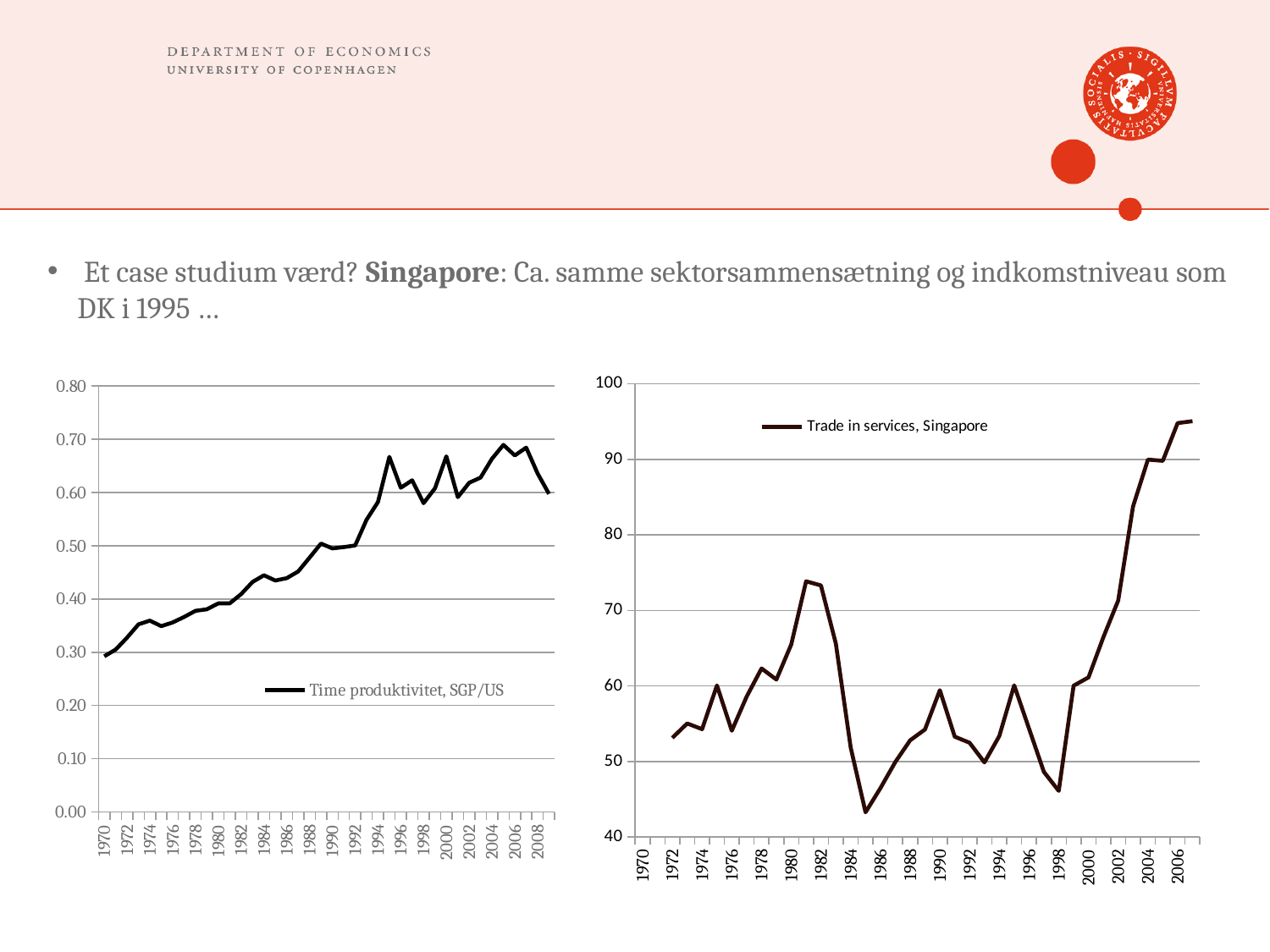
In the right chart, what series name does the legend show? Trade in services, Singapore In the left chart (Time produktivitet, SGP/US), is the value for 1970 greater or less than 0.40? less In the left chart (Time produktivitet, SGP/US), which year has the lowest value? 1970 In the right chart (Trade in services, Singapore), is the value for 1985 greater or less than 50? less What kind of chart is the right chart on the slide? line chart In the left chart (Time produktivitet, SGP/US), is the value for 2004 greater or less than 0.60? greater How many series does the legend of the right chart list? 1 What kind of chart is the left chart on the slide? line chart In the right chart (Trade in services, Singapore), which is larger, the value for 1981 or the value for 1985? 1981 In the left chart, what series name does the legend show? Time produktivitet, SGP/US In the left chart (Time produktivitet, SGP/US), do the values generally rise or fall from 1970 to 2004? rise